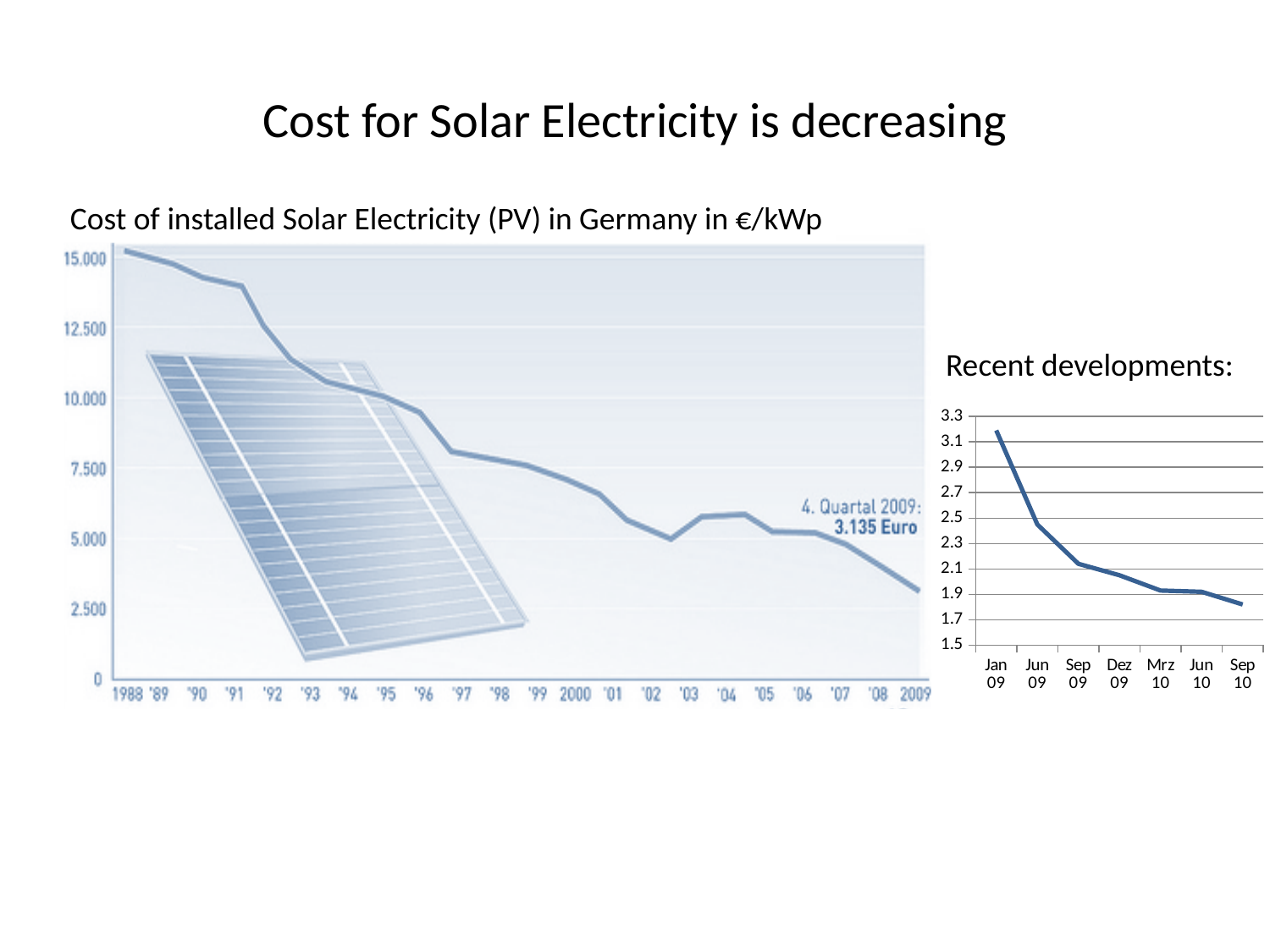
In the 'Recent developments' chart, which is larger, the value for Jun 09 or the value for Mrz 10? Jun 09 In the 'Recent developments' chart, is the value for Jan 09 greater or less than 2.9? greater In the 'Recent developments' chart, is the value for Sep 10 greater or less than 1.9? less In the 'Cost of installed Solar Electricity (PV) in Germany' chart, is the value for 1997 greater or less than 7.500? greater What kind of chart is the 'Recent developments' chart on the right of the slide? line chart In the 'Cost of installed Solar Electricity (PV) in Germany' chart, which year has the highest value? 1988 In the 'Cost of installed Solar Electricity (PV) in Germany' chart, what value is printed for the 4th quarter of 2009? 3.135 Euro In the 'Recent developments' chart, which period has the highest value? Jan 09 In the 'Cost of installed Solar Electricity (PV) in Germany' chart, do the values rise or fall from 1988 to 2009? fall In the 'Recent developments' chart, which period has the lowest value? Sep 10 In the 'Recent developments' chart, how many data points are plotted? 7